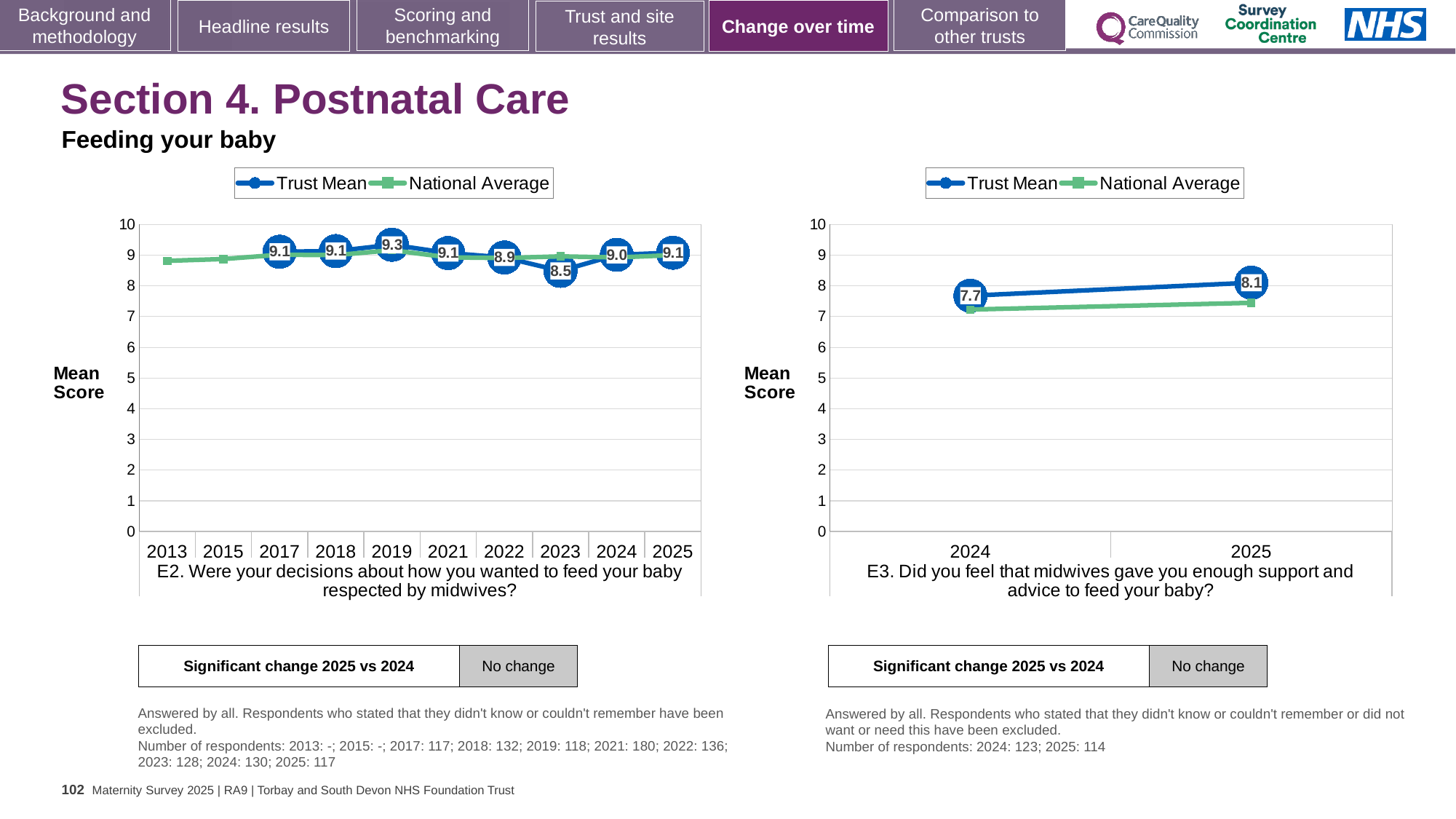
On the left chart (E2), what is the Trust Mean for 2023? 8.5 On the left chart (E2), which year has the lowest Trust Mean? 2023 On the right chart (E3), does the Trust Mean rise or fall from 2024 to 2025? Rise How many years are shown on the x axis of the left chart (E2)? 10 On the left chart (E2), is the Trust Mean higher in 2022 or 2023? 2022 On the left chart (E2), which year has the highest Trust Mean? 2019 What type of chart is the right chart (E3)? Line chart On the left chart (E2), what is the Trust Mean for 2019? 9.3 On the right chart (E3), is the National Average value for 2024 greater or less than 8? less On the right chart (E3), what is the difference between the Trust Mean for 2025 and 2024? 0.4 On the right chart (E3), what is the Trust Mean for 2024? 7.7 How many series does the legend of the right chart (E3) list? 2